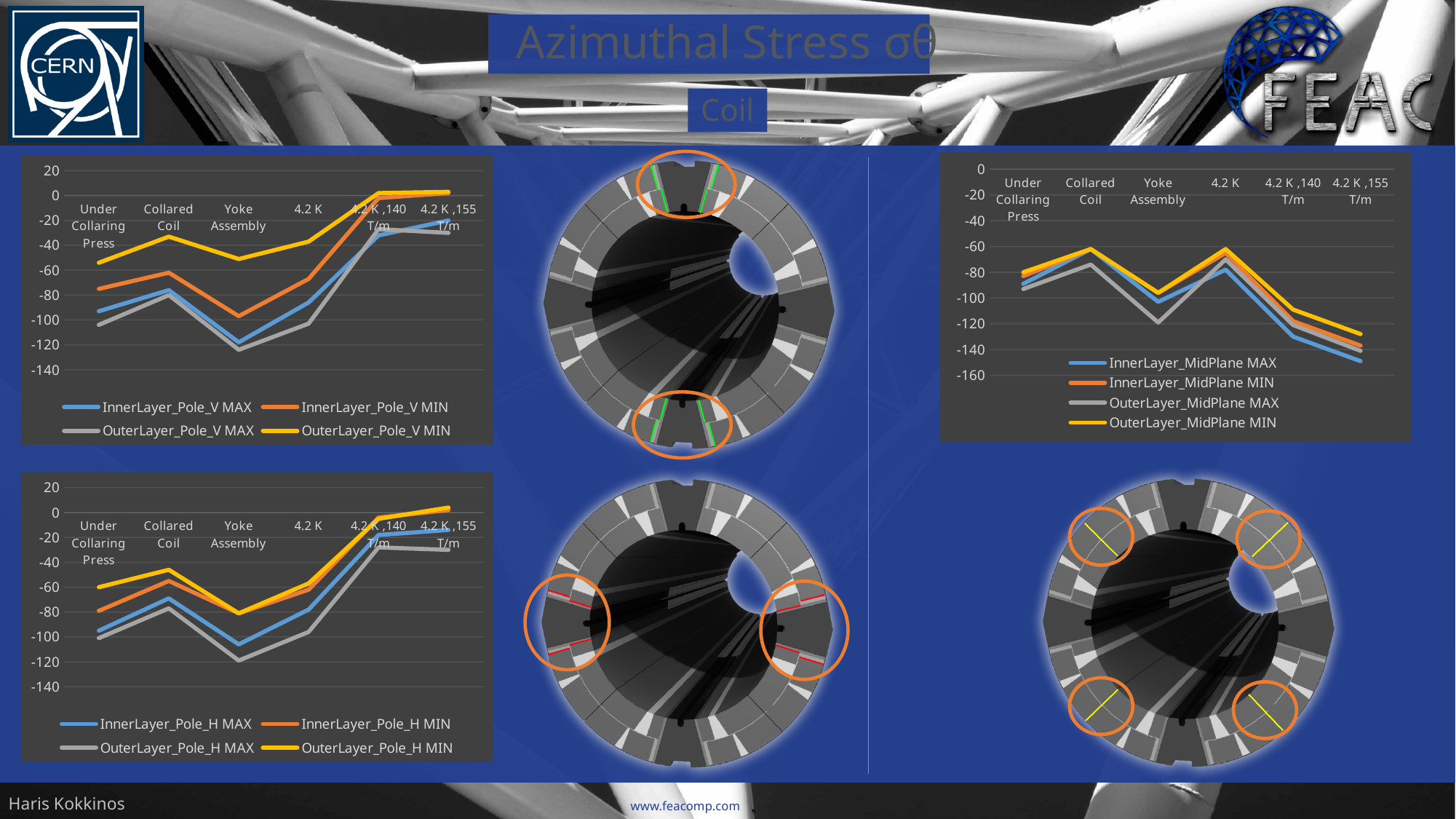
How many categories are shown on the x axis of the bottom-left chart (Pole_H)? 6 In the top-left chart (Pole_V), is the value of OuterLayer_Pole_V MIN at Under Collaring Press greater or less than -60? greater In the right-hand chart (MidPlane), do the values of InnerLayer_MidPlane MIN rise or fall from 4.2 K to 4.2 K ,155 T/m? fall In the top-left chart (Pole_V), at which category does OuterLayer_Pole_V MAX reach its lowest value? Yoke Assembly How many series does the legend of the right-hand chart (MidPlane) list? 4 In the right-hand chart (MidPlane), at which category does OuterLayer_MidPlane MAX reach its lowest value? 4.2 K ,155 T/m What kind of chart is the top-left chart (Pole_V)? line chart In the top-left chart (Pole_V), is the value of OuterLayer_Pole_V MAX at Yoke Assembly greater or less than -100? less In the top-left chart (Pole_V), at Yoke Assembly, which is larger: OuterLayer_Pole_V MIN or InnerLayer_Pole_V MIN? OuterLayer_Pole_V MIN In the bottom-left chart (Pole_H), do the values of InnerLayer_Pole_H MAX rise or fall from Yoke Assembly to 4.2 K ,155 T/m? rise In the bottom-left chart (Pole_H), is the value of OuterLayer_Pole_H MAX at Yoke Assembly greater or less than -100? less